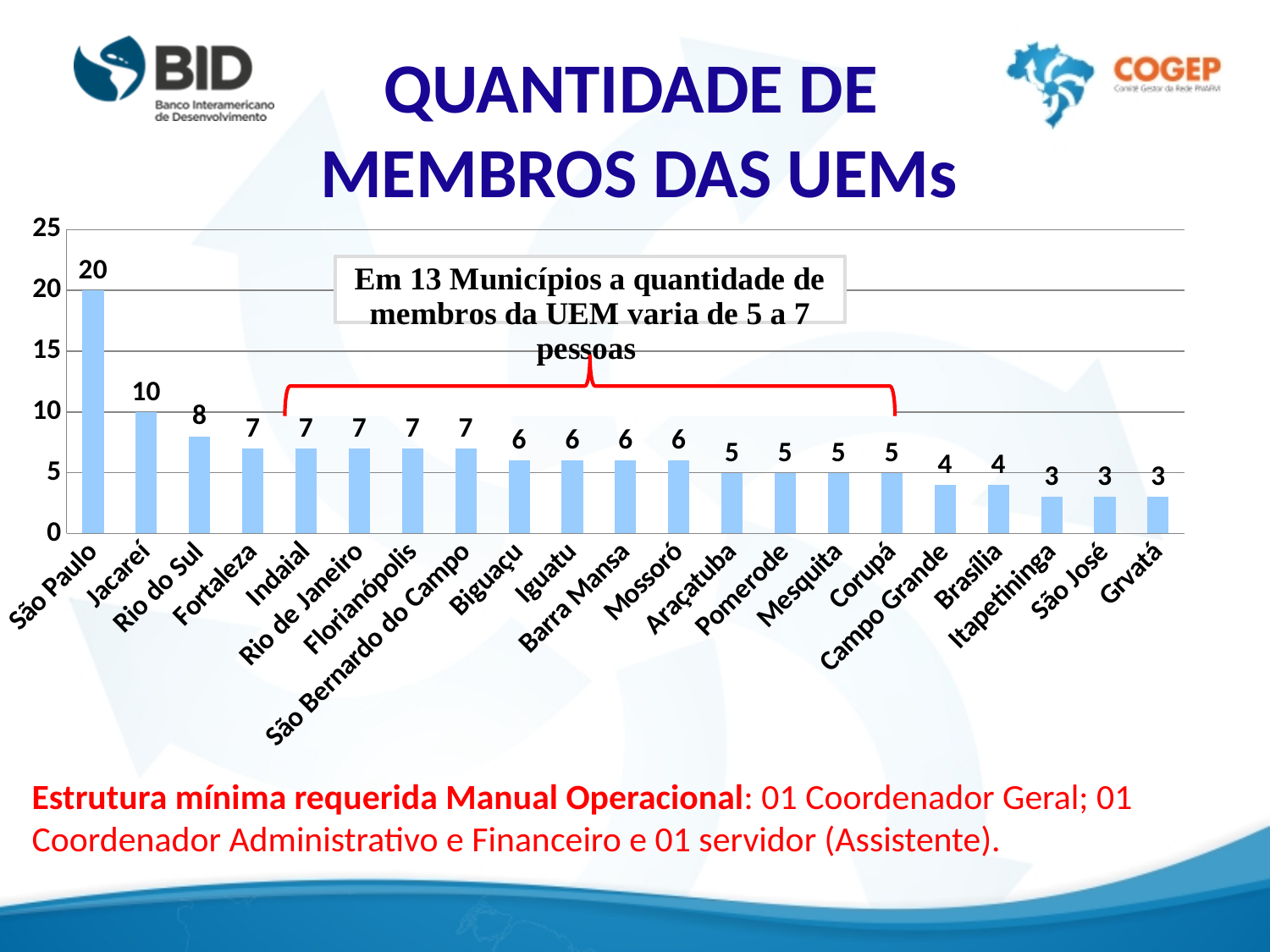
What is the value for São Bernardo do Campo? 7 Do the values rise or fall from left to right along the x axis? fall What is the value for São Paulo? 20 Which is larger, the value for Mossoró or the value for Mesquita? Mossoró What kind of chart is shown on the slide? bar chart What is the difference between the values for São Paulo and Jacareí? 10 Is the value for Fortaleza greater or less than 10? less Which municipality has the highest value? São Paulo What is the value for Rio do Sul? 8 What is the value for Jacareí? 10 How many municipalities are shown on the x axis? 21 What is the value for Brasília? 4